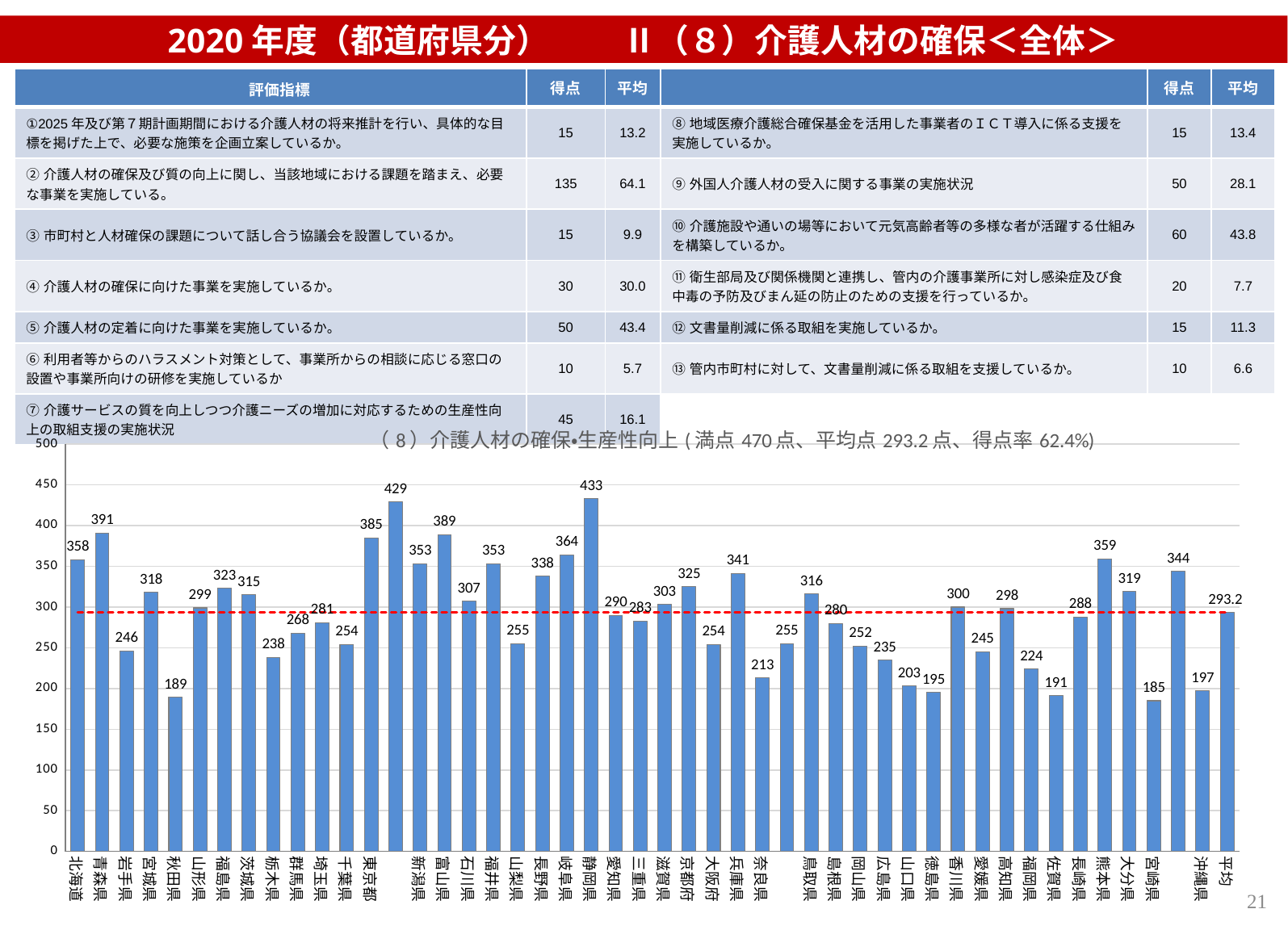
What value does the red dashed horizontal line in the bar chart mark? 293.2 What is the value for 青森県 in the bar chart? 391 What is the lowest value shown in the bar chart? 185 What is the difference between the values for 東京都 and 北海道 in the bar chart? 27 What is the value for 北海道 in the bar chart? 358 Is the value for 秋田県 in the bar chart greater or less than 200? less Which has a larger value in the bar chart, 兵庫県 or 京都府? 兵庫県 What is the value of the 平均 bar in the bar chart? 293.2 What is the difference between the values for 富山県 and 石川県 in the bar chart? 82 What kind of chart is shown at the bottom of the slide? bar chart What is the value for 岐阜県 in the bar chart? 364 Which prefecture has the highest value in the bar chart? 静岡県